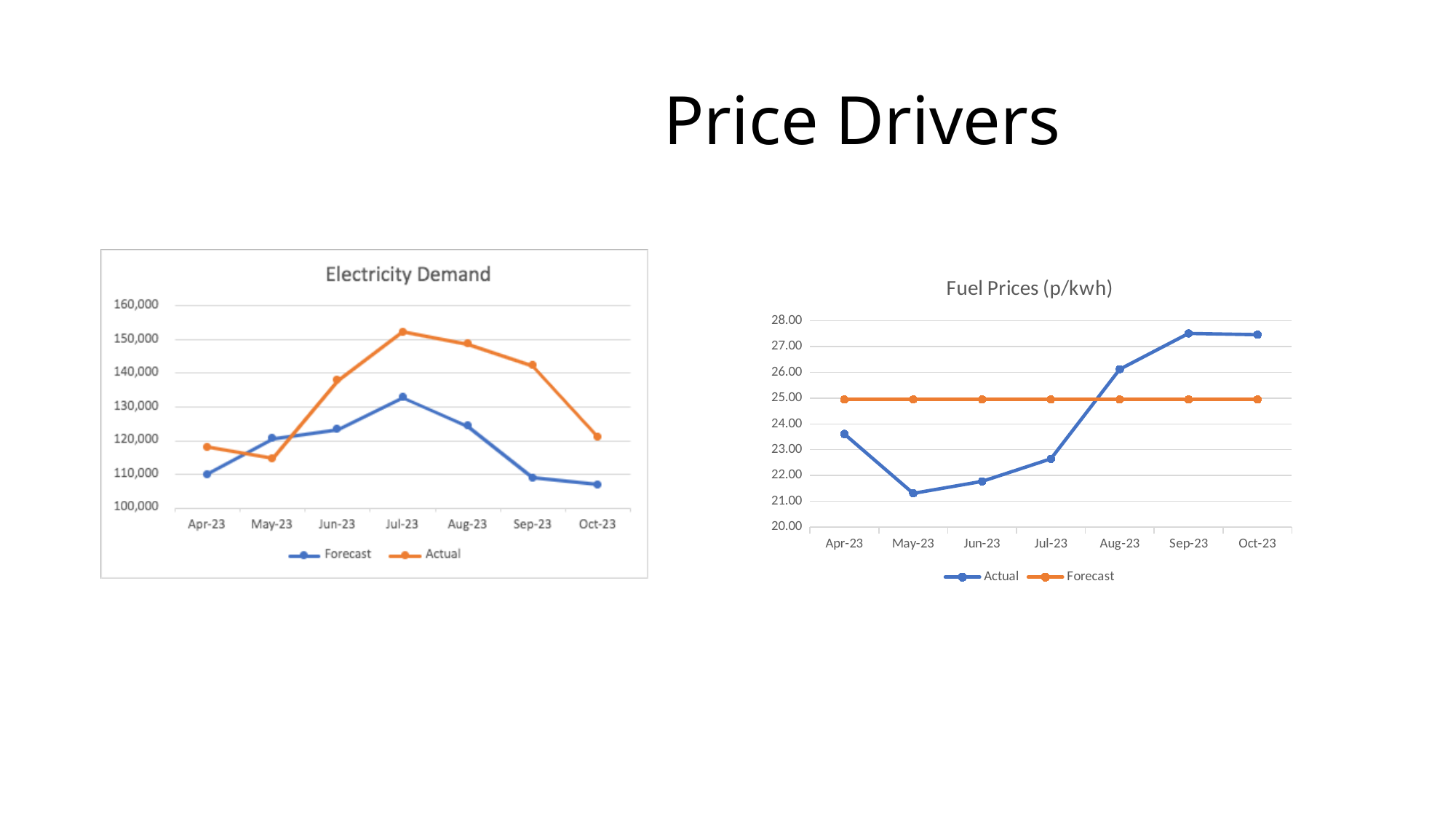
In the Electricity Demand chart, in which month is the Forecast series at its lowest? Oct-23 In the Fuel Prices (p/kwh) chart, in which month is the Actual series at its lowest? May-23 What type of chart is the Electricity Demand chart? line chart In the Electricity Demand chart, which series is higher in Aug-23, Forecast or Actual? Actual In the Fuel Prices (p/kwh) chart, which series is higher in Jun-23, Actual or Forecast? Forecast How many series does the legend of the Fuel Prices (p/kwh) chart list? 2 How many months are shown on the x axis of the Electricity Demand chart? 7 In the Fuel Prices (p/kwh) chart, is the Actual value for Sep-23 greater or less than 27.00? greater In the Fuel Prices (p/kwh) chart, does the Actual series rise or fall from Jul-23 to Sep-23? rise In the Electricity Demand chart, is the Actual value for Jul-23 greater or less than 140,000? greater In the Electricity Demand chart, in which month does the Actual series reach its highest value? Jul-23